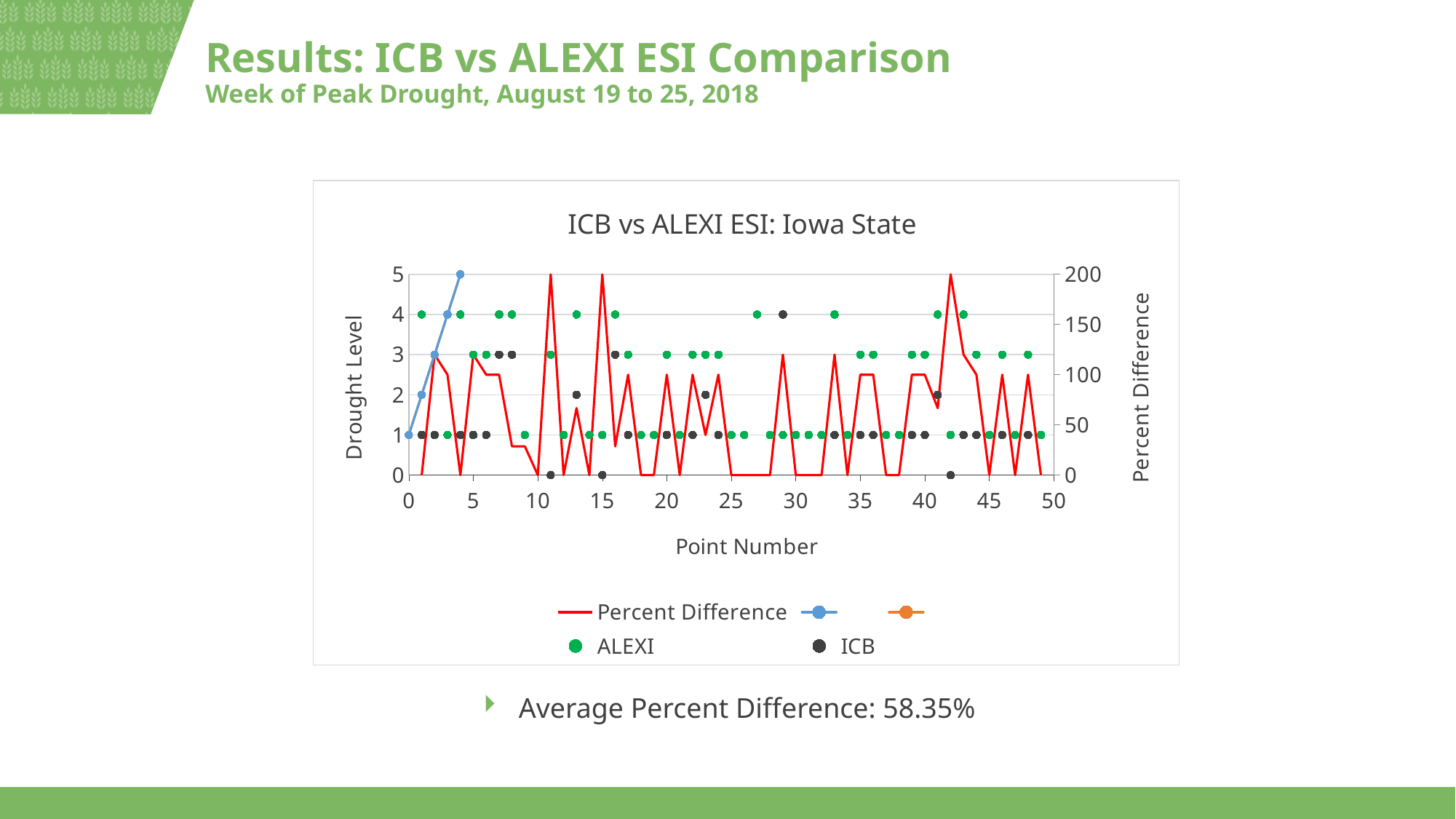
What is the title of the chart? ICB vs ALEXI ESI: Iowa State What is the Percent Difference value at point number 11? 200 What is the lowest value reached by the Percent Difference series? 0 What is the label of the x axis of the chart? Point Number Is the Percent Difference value at point number 15 greater or less than 150? greater Which is larger at point number 29, the ICB drought level or the ALEXI drought level? ICB Is the Percent Difference value at point number 13 greater or less than 100? less What is the ICB drought level at point number 29? 4 What is the ALEXI drought level at point number 27? 4 What is the highest value reached by the Percent Difference series? 200 What is the ICB drought level at point number 11? 0 What kind of chart is shown on the slide? line chart